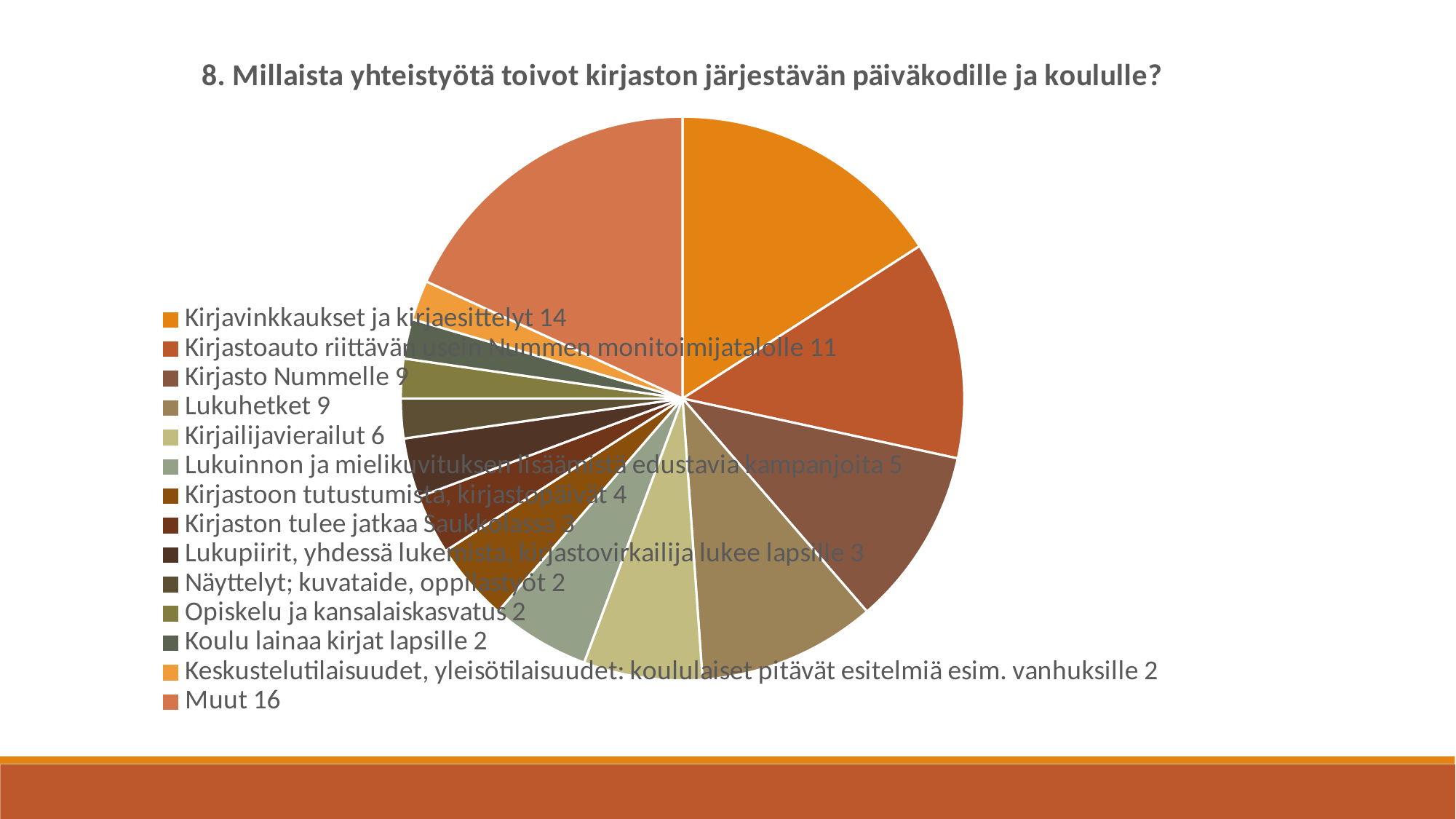
What is the difference between the values for Muut and Kirjavinkkaukset ja kirjaesittelyt? 2 How many categories does the pie chart have? 14 What is the value for Kirjailijavierailut? 6 What kind of chart is shown on the slide? pie chart What is the difference between the values for Kirjasto Nummelle and Kirjailijavierailut? 3 What is the value for Muut? 16 Which category has the largest slice of the pie? Muut What is the title of the chart? 8. Millaista yhteistyötä toivot kirjaston järjestävän päiväkodille ja koululle? What is the value for Kirjavinkkaukset ja kirjaesittelyt? 14 What is the value for Kirjastoauto riittävän usein Nummen monitoimijatalolle? 11 What is the total of all the values shown in the legend? 88 Which is larger, the value for Kirjastoon tutustumista, kirjastopäivät or the value for Lukuhetket? Lukuhetket